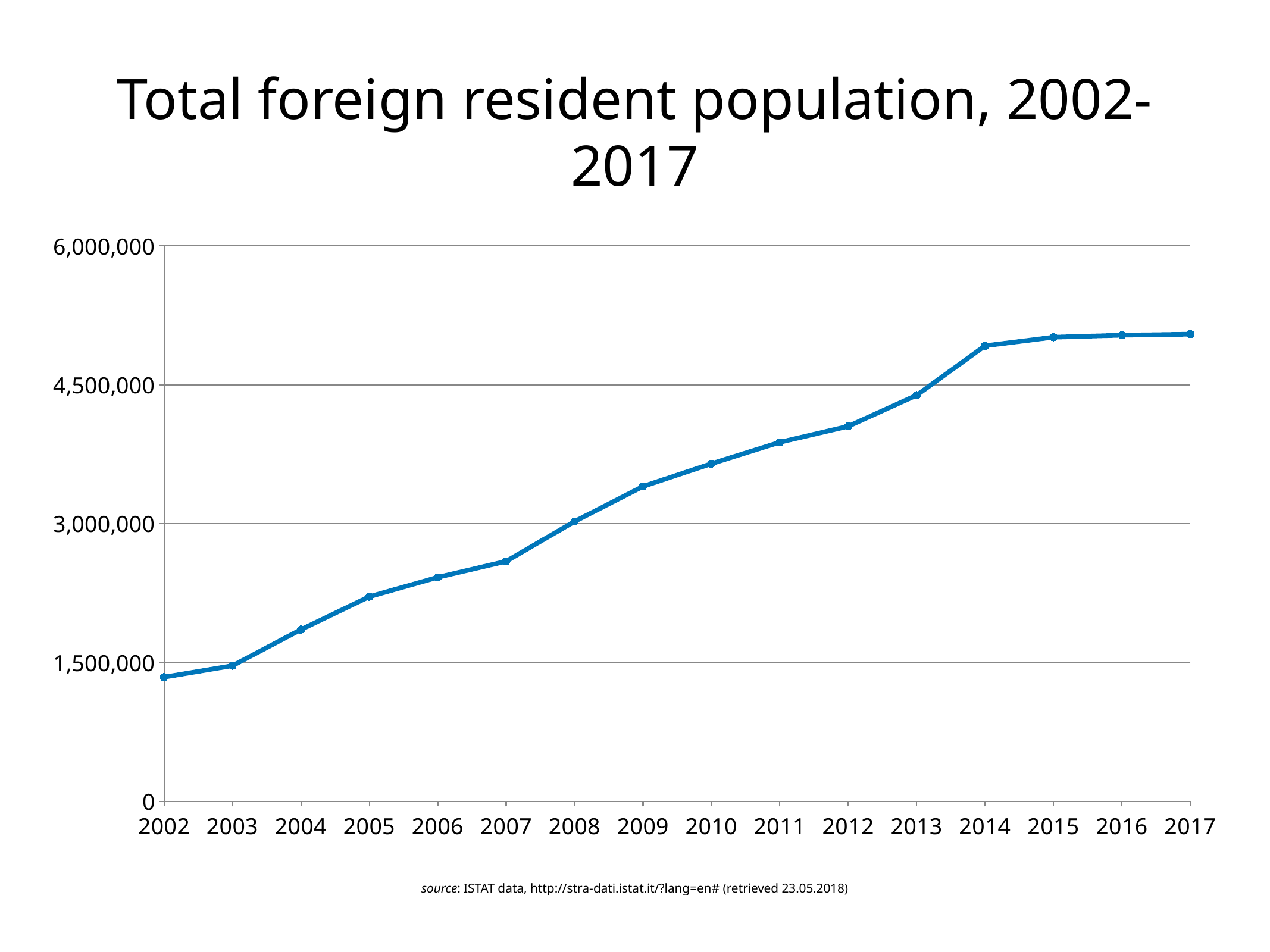
What is the title of the chart? Total foreign resident population, 2002-2017 Is the value for 2017 greater or less than 6,000,000? less Is the value for 2007 greater or less than 3,000,000? less Is the value for 2004 greater or less than 1,500,000? greater Which year has the larger value, 2005 or 2010? 2010 What kind of chart is shown on the slide? line chart How many years are plotted on the x axis? 16 Which year has the lowest total foreign resident population? 2002 Do the values generally rise or fall from 2002 to 2017? rise